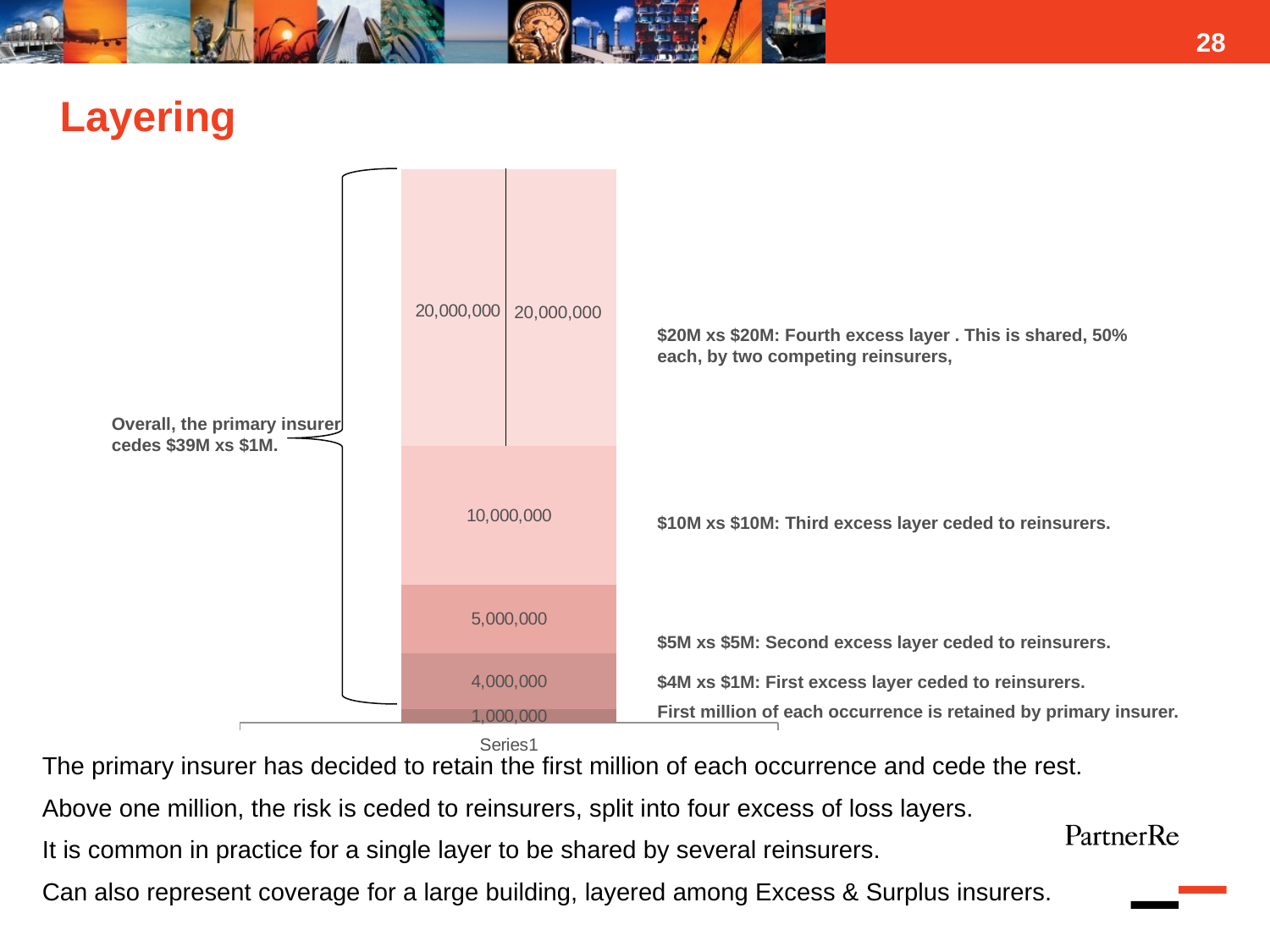
What value is printed on the bottom segment of the stacked bar? 1,000,000 What is the category label shown on the x axis of the chart? Series1 What value is printed on the segment directly above the 1,000,000 segment? 4,000,000 What is the smallest value printed on any segment of the bar? 1,000,000 What is the difference between the 20,000,000 segment and the 10,000,000 segment? 10,000,000 Which is larger, the segment labelled 4,000,000 or the segment labelled 5,000,000? 5,000,000 What value is printed on the segment labelled as the third excess layer ($10M xs $10M)? 10,000,000 What is the largest value printed on any segment of the bar? 20,000,000 How many categories are shown on the x axis of the chart? 1 What kind of chart is shown on the slide? Bar chart What value is printed on the third segment from the bottom of the bar? 5,000,000 What is the difference between the 10,000,000 segment and the 5,000,000 segment? 5,000,000